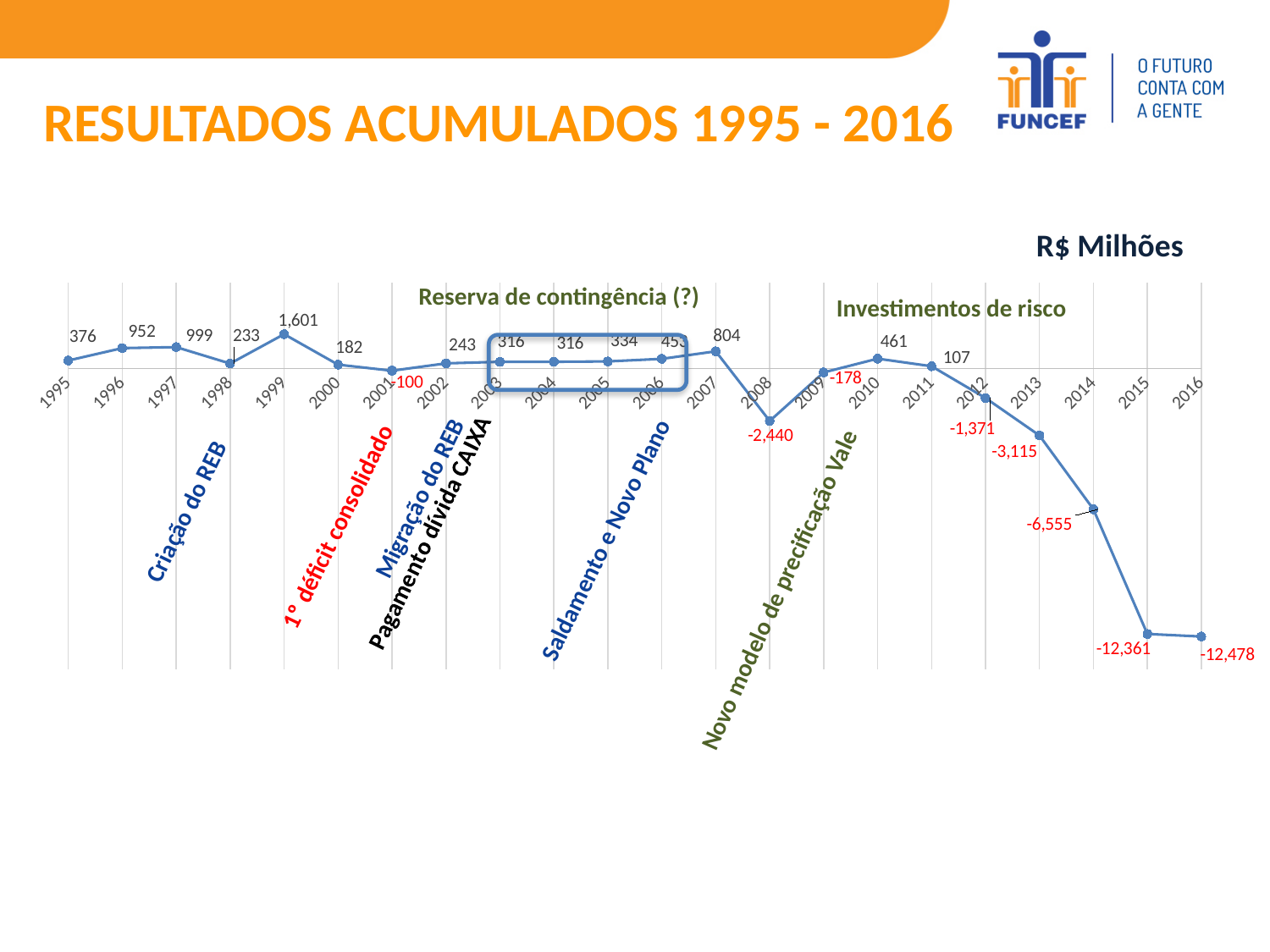
What unit is indicated for the chart values? R$ Milhões What is the value for 2008? -2,440 What kind of chart is shown? line chart What is the value for 1999? 1,601 What is the value for 2016? -12,478 Which year has the lowest value? 2016 Which is larger, the value for 2007 or the value for 2010? 2007 Which year has the highest value? 1999 What is the value for 2001? -100 Do the values rise or fall from 2013 to 2016? fall What is the difference between the values for 1997 and 1998? 766 How many years are plotted on the x axis? 22